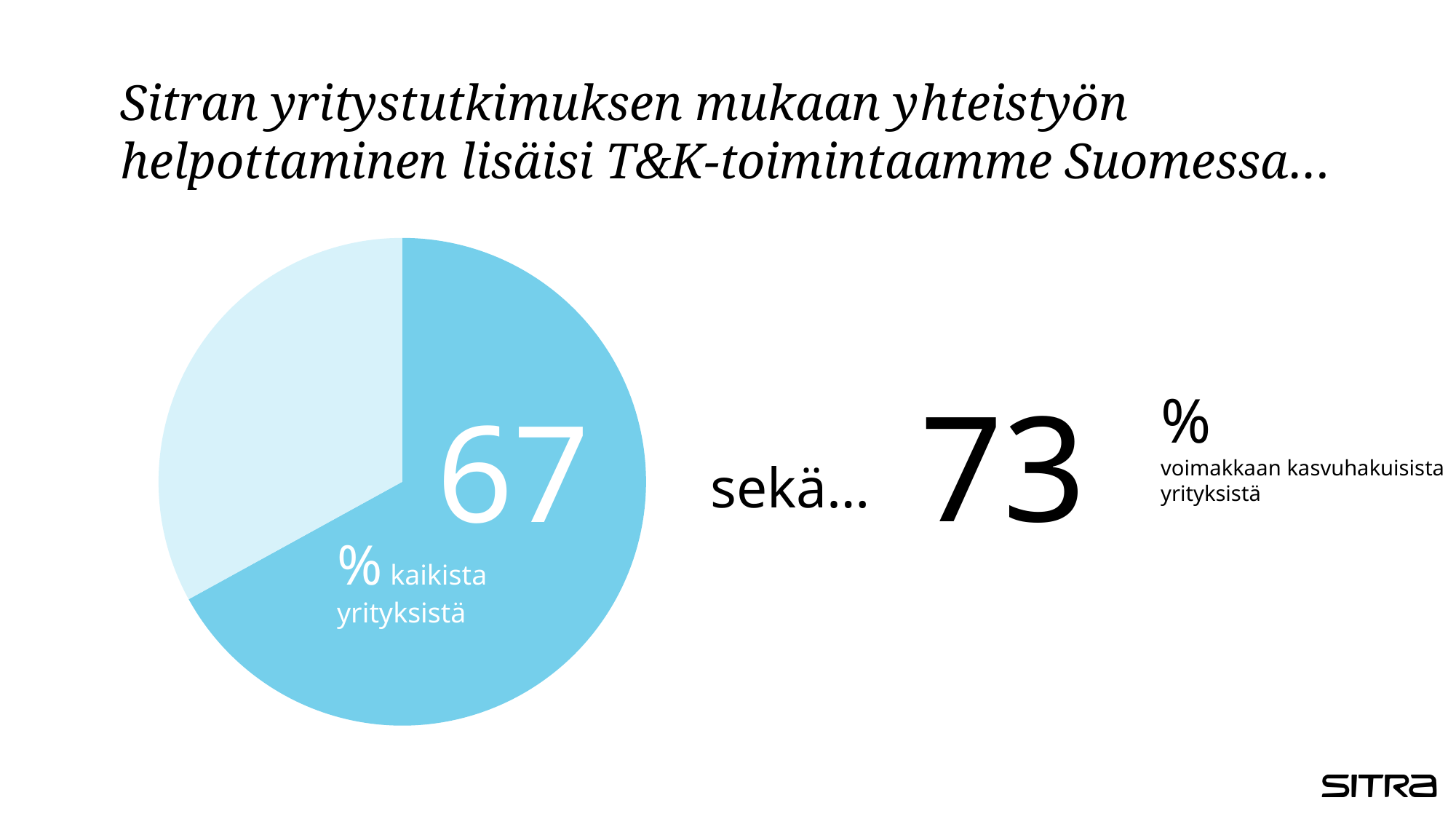
What share of all companies (kaikista yrityksistä) does the pie chart show? 67% Which slice of the pie chart is larger, the darker blue slice or the lighter blue slice? the darker blue slice How many slices does the pie chart have? 2 What label accompanies the 67% value inside the pie chart? % kaikista yrityksistä Is the share of the darker blue slice in the pie chart greater or less than 50%? greater What colour is the slice labelled 67% in the pie chart? darker blue Is the share of the lighter blue slice in the pie chart greater or less than 50%? less What kind of chart is shown on the slide? pie chart